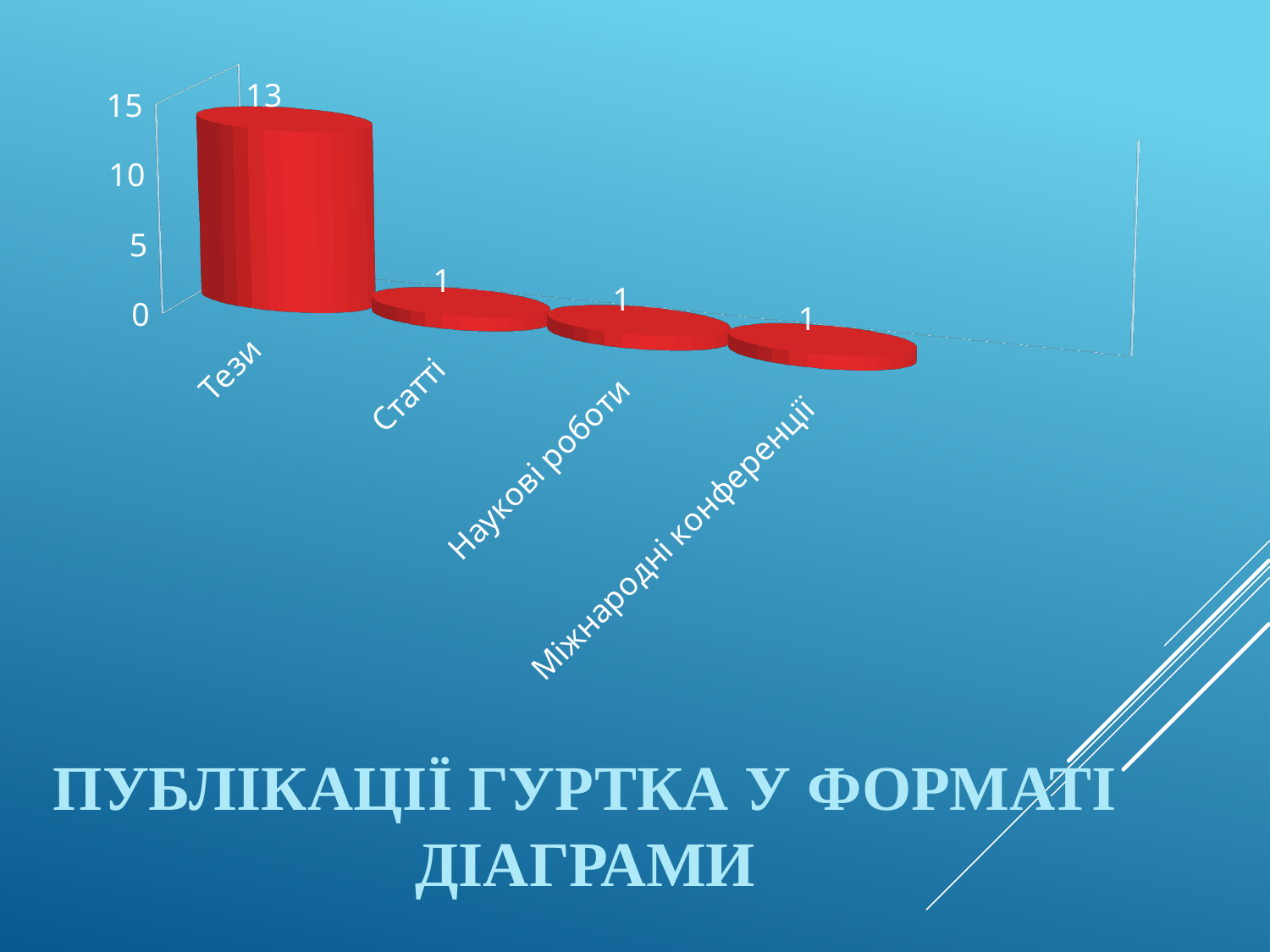
What is the value for Статті? 1 Is the value for Міжнародні конференції greater or less than 5? less How many categories are shown on the chart? 4 What kind of chart is shown on the slide? bar chart Which category has the highest value? Тези What is the value for Міжнародні конференції? 1 What is the value for Тези? 13 Is the value for Тези greater or less than 10? greater Which is larger, the value for Тези or the value for Наукові роботи? Тези What colour are the bars in the chart? red What is the value for Наукові роботи? 1 What is the difference between the values for Тези and Статті? 12